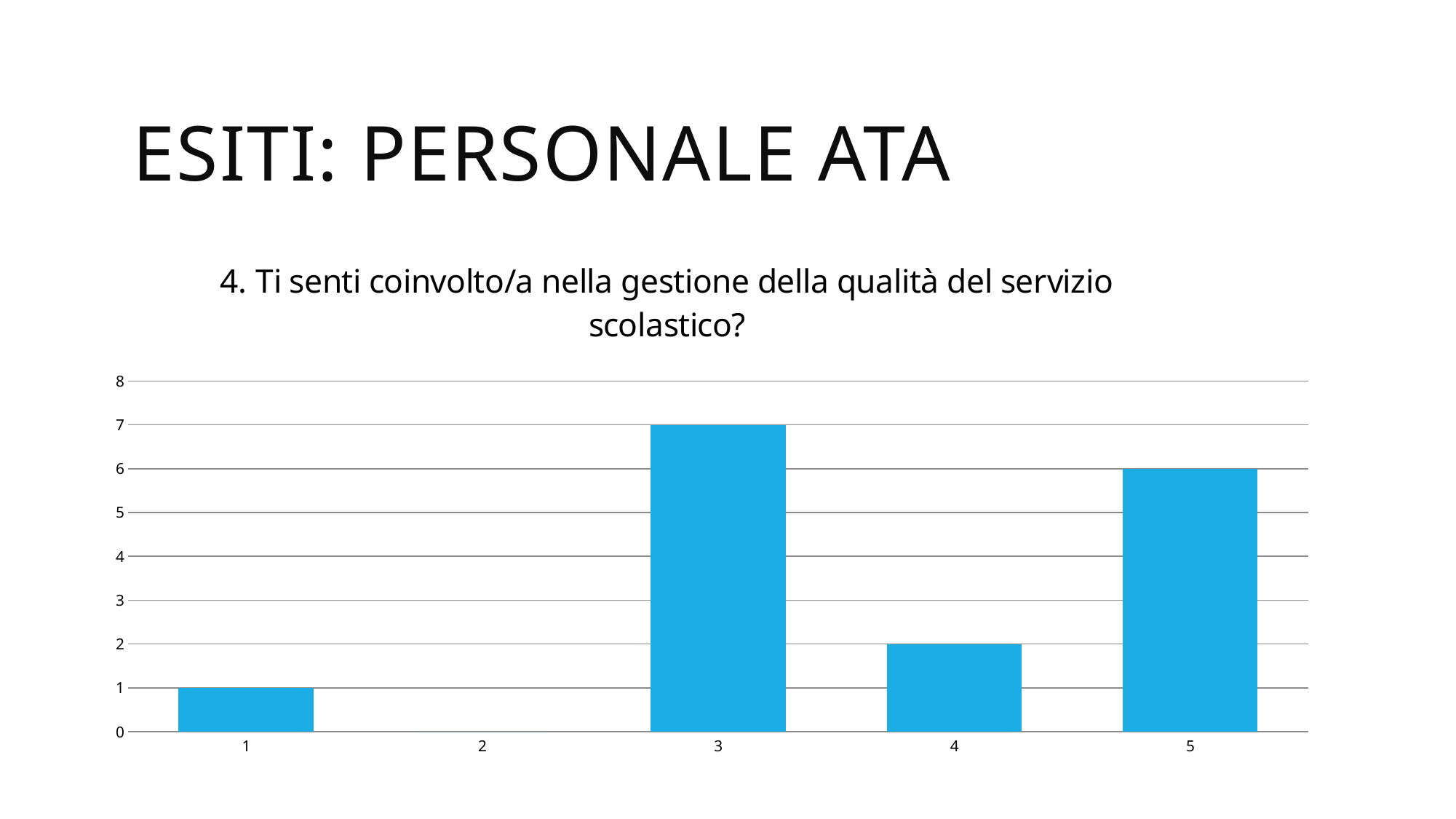
How many categories are shown on the x axis of the chart? 5 Which category has the highest value? 3 What is the value for category 4? 2 What is the value for category 5? 6 What is the value for category 3? 7 Which is larger, the value for category 4 or the value for category 5? 5 Is the value for category 3 greater or less than 5? greater What is the title of the chart? 4. Ti senti coinvolto/a nella gestione della qualità del servizio scolastico? What type of chart is shown on the slide? bar chart What is the value for category 1? 1 What is the difference between the values for category 3 and category 5? 1 Which category has the lowest value? 2